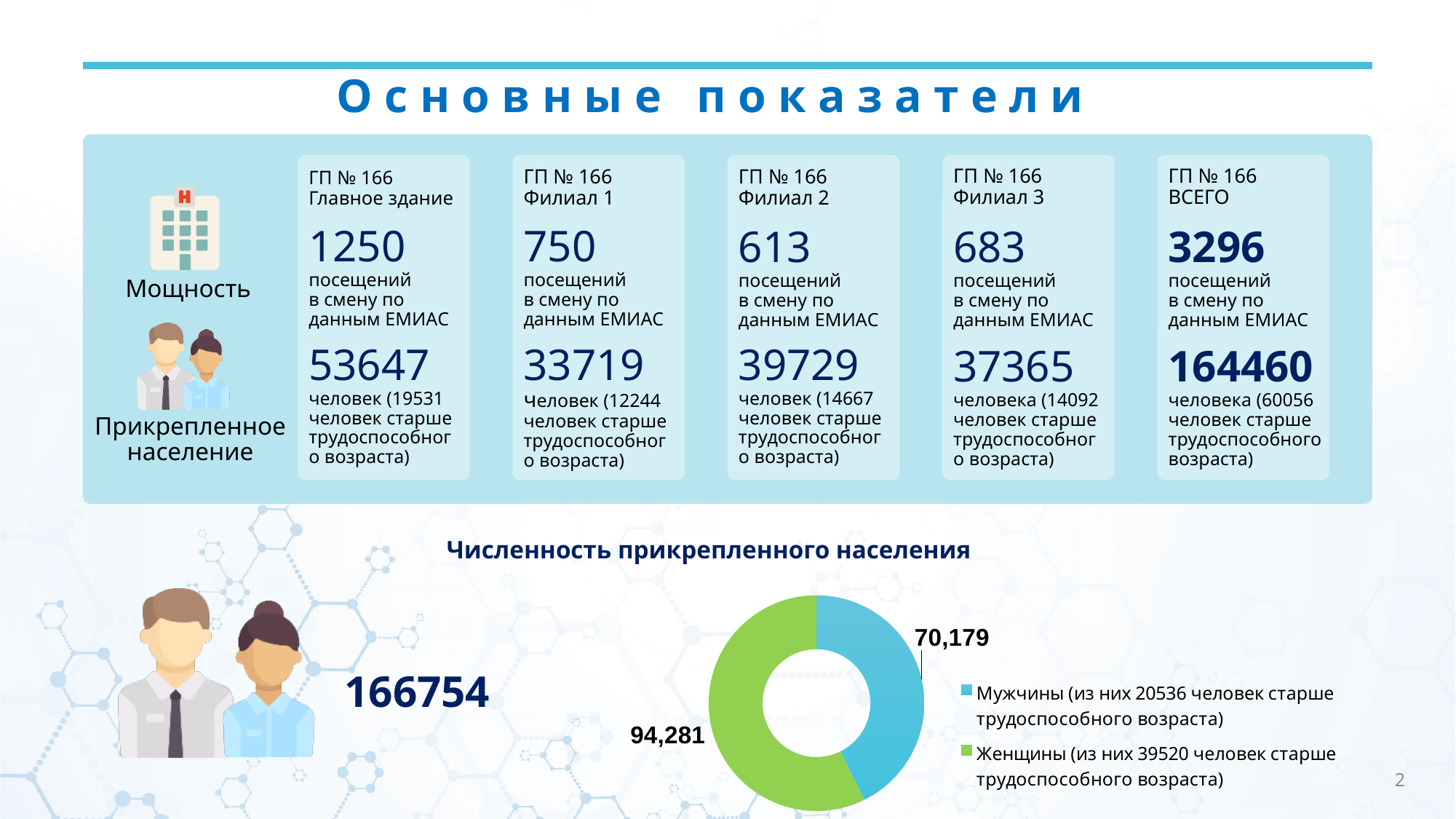
What kind of chart is shown under the title "Численность прикрепленного населения"? Doughnut (pie) chart In the doughnut chart, what is the value for Мужчины? 70,179 What is the difference between the Женщины and Мужчины values in the doughnut chart? 24,102 What is the total of the two slices in the doughnut chart? 164,460 How many slices does the doughnut chart have? 2 Which category in the doughnut chart has the larger value? Женщины Which category in the doughnut chart has the smaller value? Мужчины How many entries does the legend of the doughnut chart list? 2 What colour is the Женщины slice in the doughnut chart? Green In the doughnut chart, what is the value for Женщины? 94,281 What is the title of the doughnut chart? Численность прикрепленного населения In the doughnut chart, is the value for Женщины larger or smaller than the value for Мужчины? larger